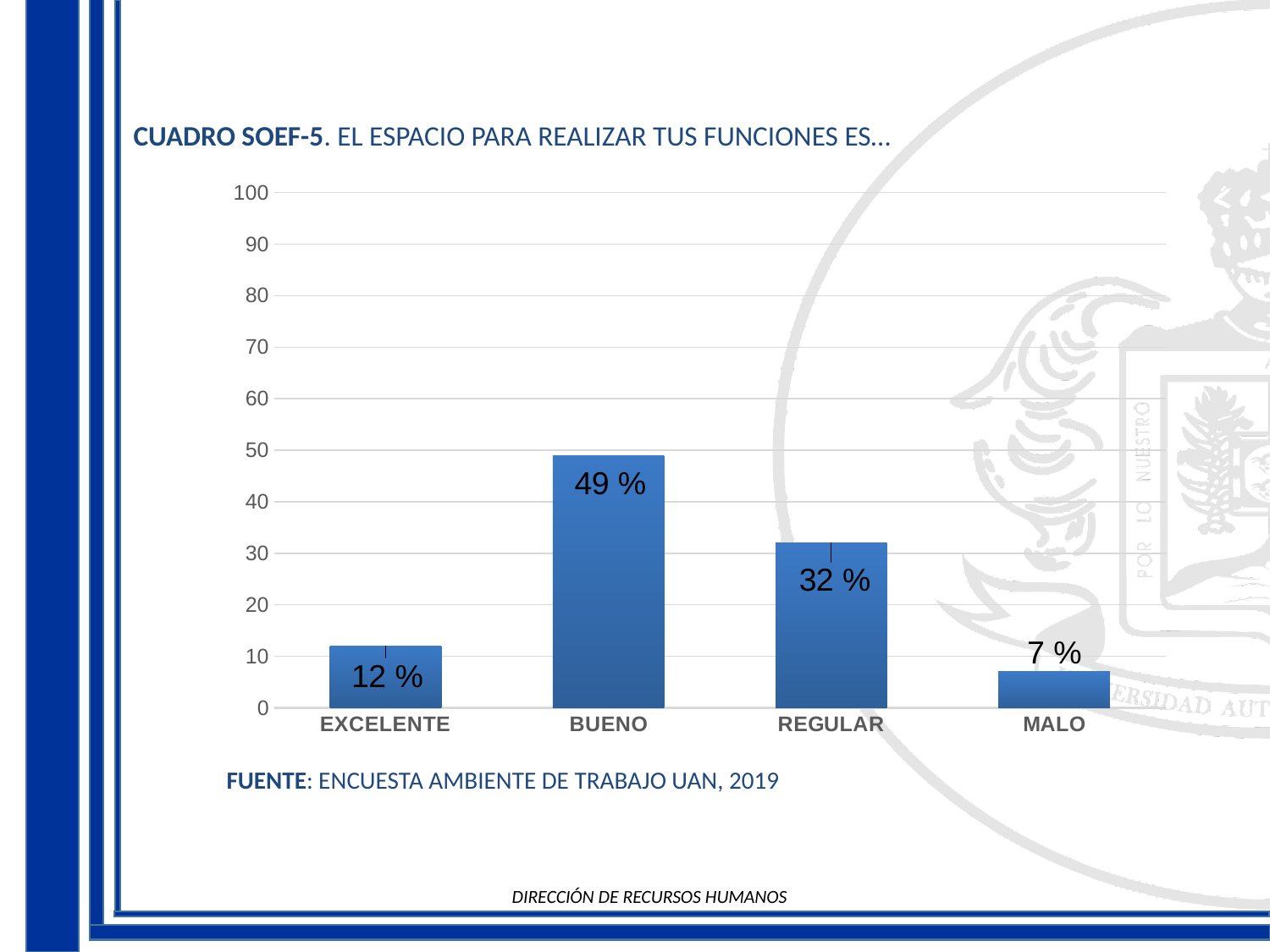
Is the value for REGULAR greater or less than 30? greater Which category has the highest value? BUENO What is the value for EXCELENTE? 12 % Which category has the lowest value? MALO How many categories are shown on the x axis? 4 What is the difference between the values for EXCELENTE and MALO? 5 % What kind of chart is shown on the slide? bar chart What is the value for MALO? 7 % Which is larger, the value for REGULAR or the value for EXCELENTE? REGULAR What is the source cited below the chart? ENCUESTA AMBIENTE DE TRABAJO UAN, 2019 What is the difference between the values for BUENO and REGULAR? 17 % What is the value for BUENO? 49 %